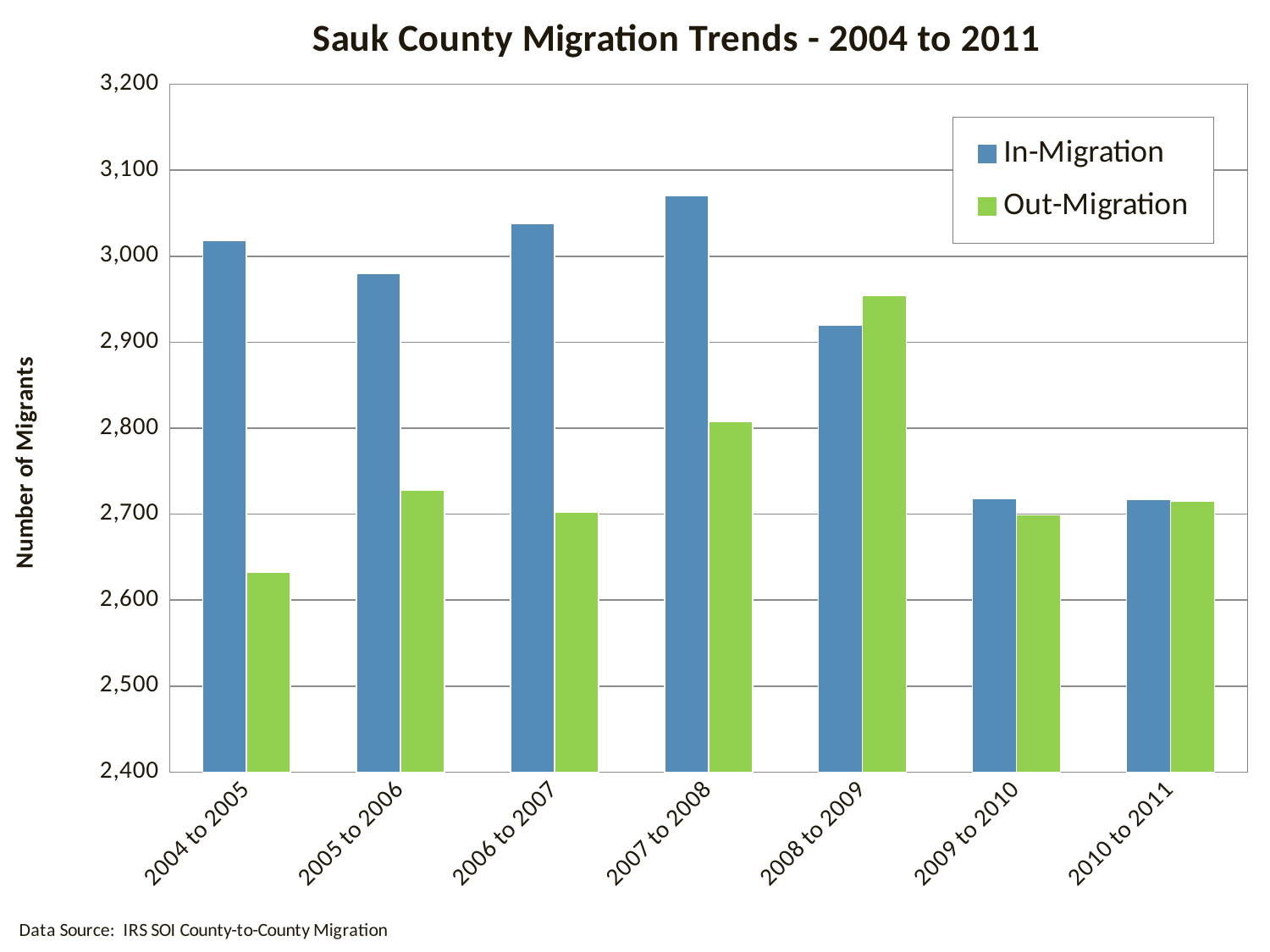
Is the In-Migration value for 2007 to 2008 greater or less than 3,000? greater How many series does the legend list? 2 How many time periods are shown on the x axis? 7 For 2008 to 2009, which is larger, In-Migration or Out-Migration? Out-Migration In which period is In-Migration highest? 2007 to 2008 In which period is Out-Migration highest? 2008 to 2009 What is the label on the y axis? Number of Migrants What kind of chart is shown on the slide? Bar chart Does In-Migration rise or fall from 2007 to 2008 through 2009 to 2010? Fall Is the Out-Migration value for 2004 to 2005 greater or less than 2,700? less In which period is Out-Migration lowest? 2004 to 2005 Is the In-Migration value for 2005 to 2006 greater or less than 3,000? less